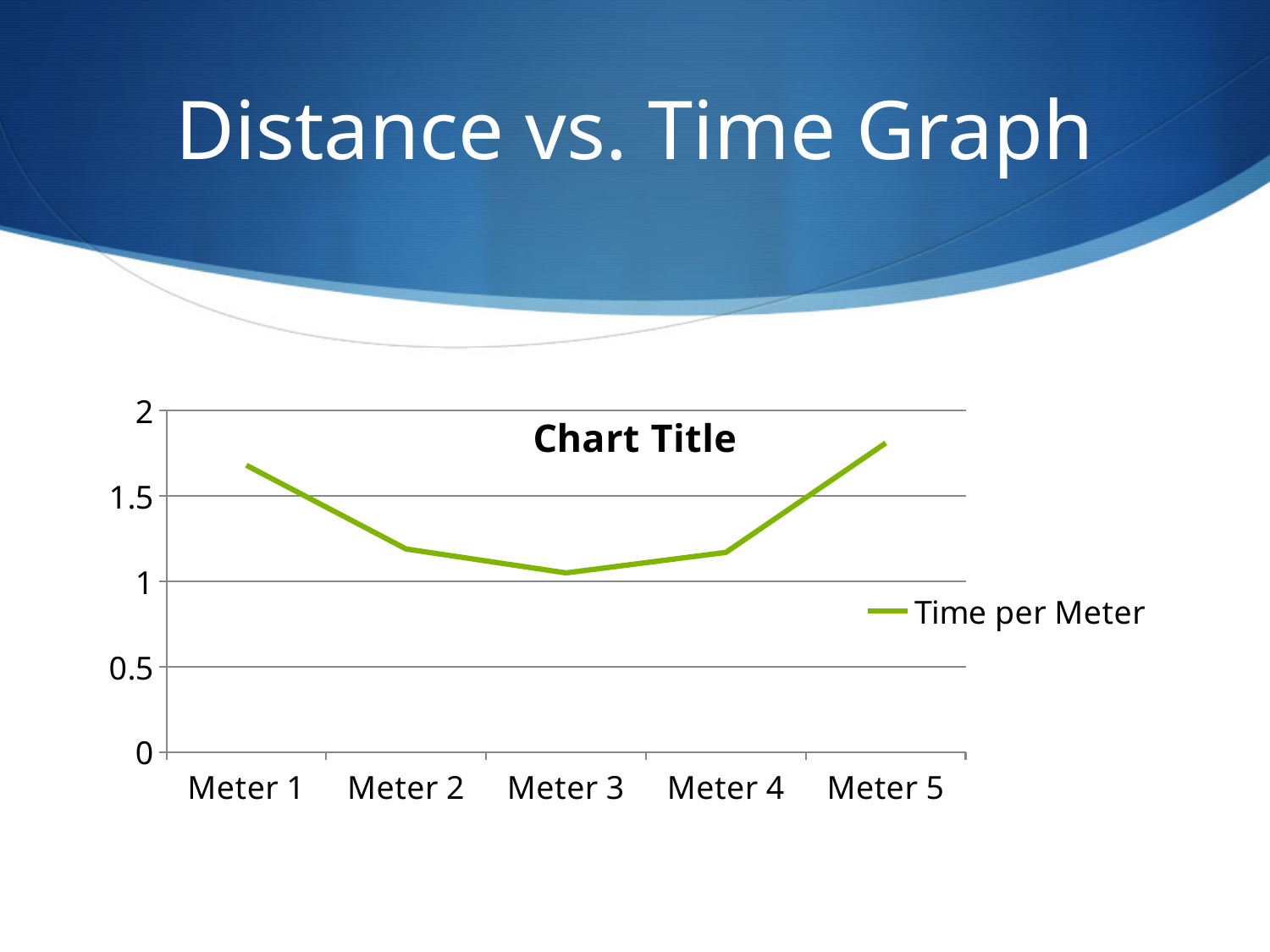
How many categories are plotted along the x axis? 5 Is the value for Meter 1 greater or less than 1.5? greater How does the Time per Meter line change from Meter 1 to Meter 5? It falls to Meter 3, then rises Is the value for Meter 5 greater or less than 1.5? greater What kind of chart is shown on the slide? line chart Which category has the lowest value for Time per Meter? Meter 3 Which category has the highest value for Time per Meter? Meter 5 Is the value for Meter 2 greater or less than 1.5? less How many series does the legend list? 1 Which is larger, the value for Meter 1 or the value for Meter 2? Meter 1 What series name is shown in the legend? Time per Meter